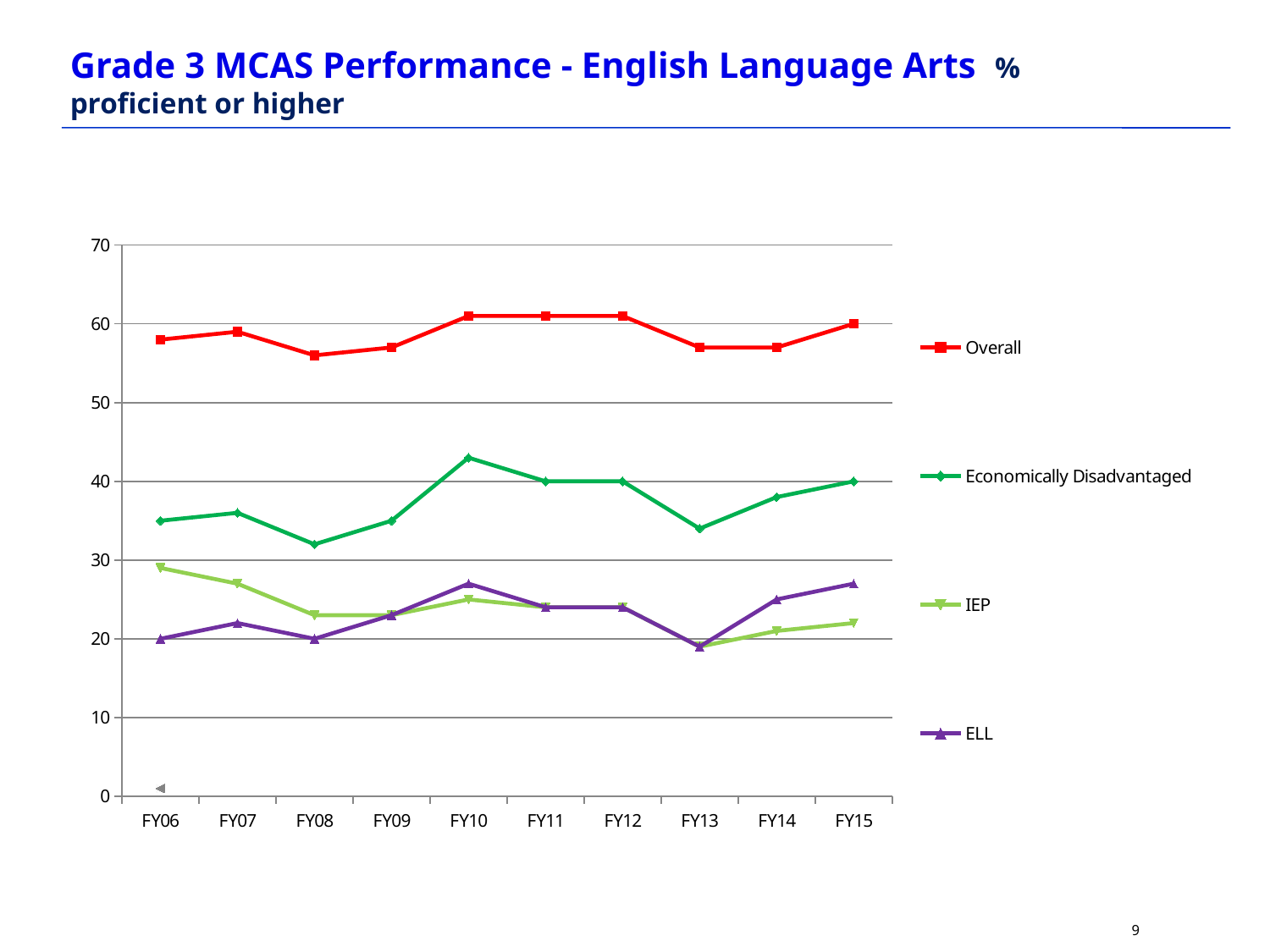
How many fiscal years are shown on the x axis? 10 In FY06, which is larger: the IEP value or the ELL value? IEP How many series does the legend list? 4 What colour is the Overall line in the legend? Red Is the Economically Disadvantaged value for FY10 greater or less than 40? greater Is the Overall value for FY08 greater or less than 60? less Which series has the lowest value in FY06? ELL Which series has the highest values across all years? Overall In FY10, which is larger: the Economically Disadvantaged value or the IEP value? Economically Disadvantaged What kind of chart is shown on the slide? Line chart Does the Overall line rise or fall from FY12 to FY13? Falls Is the IEP value for FY06 greater or less than 20? greater